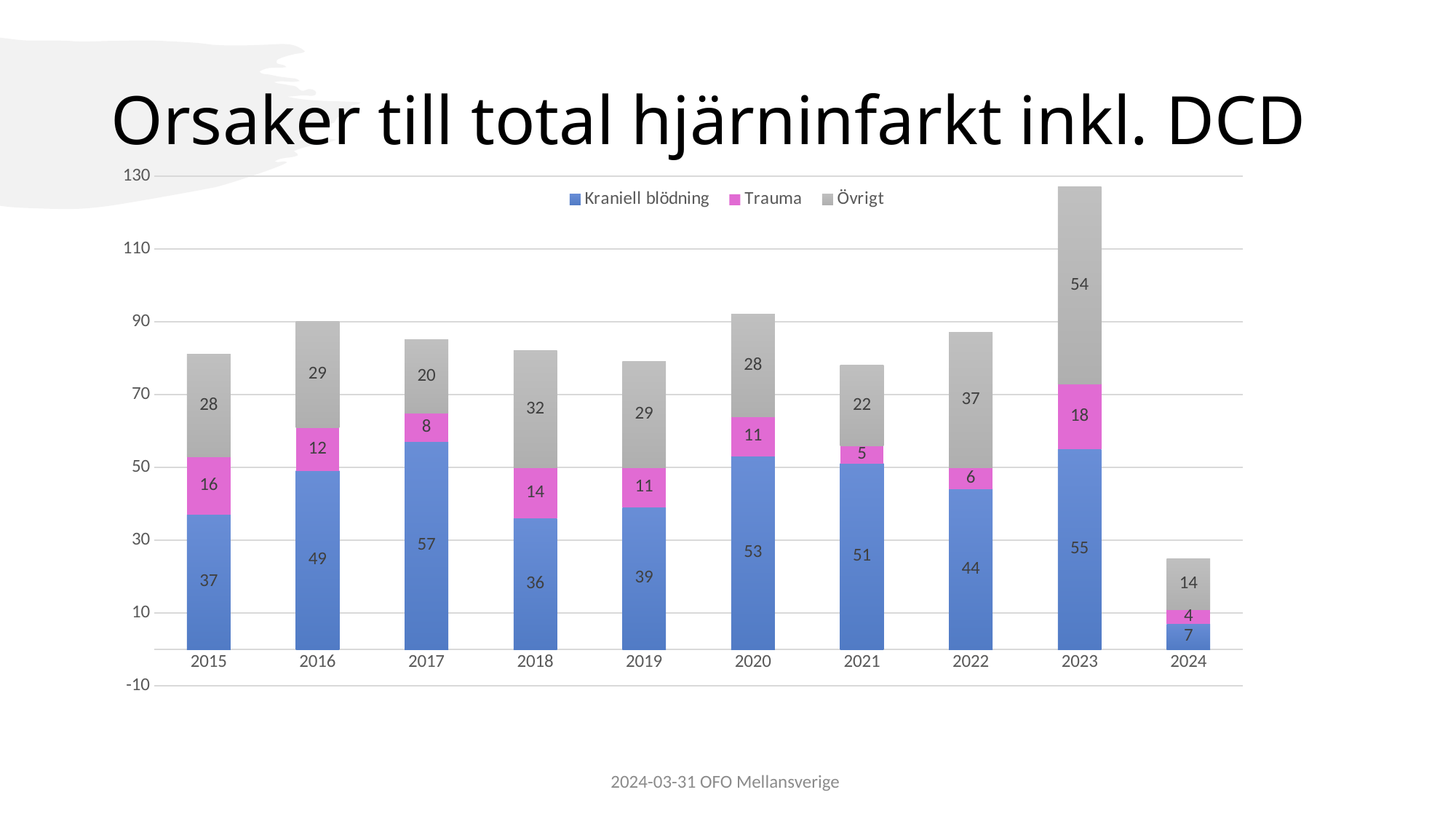
What is the total of the stacked bar for 2024? 25 What kind of chart is shown on the slide? Stacked bar chart Which year has the lowest value for Kraniell blödning? 2024 What is the value for Övrigt in 2023? 54 What is the difference between the Kraniell blödning values for 2023 and 2022? 11 What is the value for Kraniell blödning in 2017? 57 Which year has the highest value for Övrigt? 2023 How many years are shown on the x axis? 10 Which is larger, the Trauma value for 2015 or for 2016? 2015 What is the total of the stacked bar for 2016? 90 What is the value for Trauma in 2021? 5 How many series does the legend list? 3